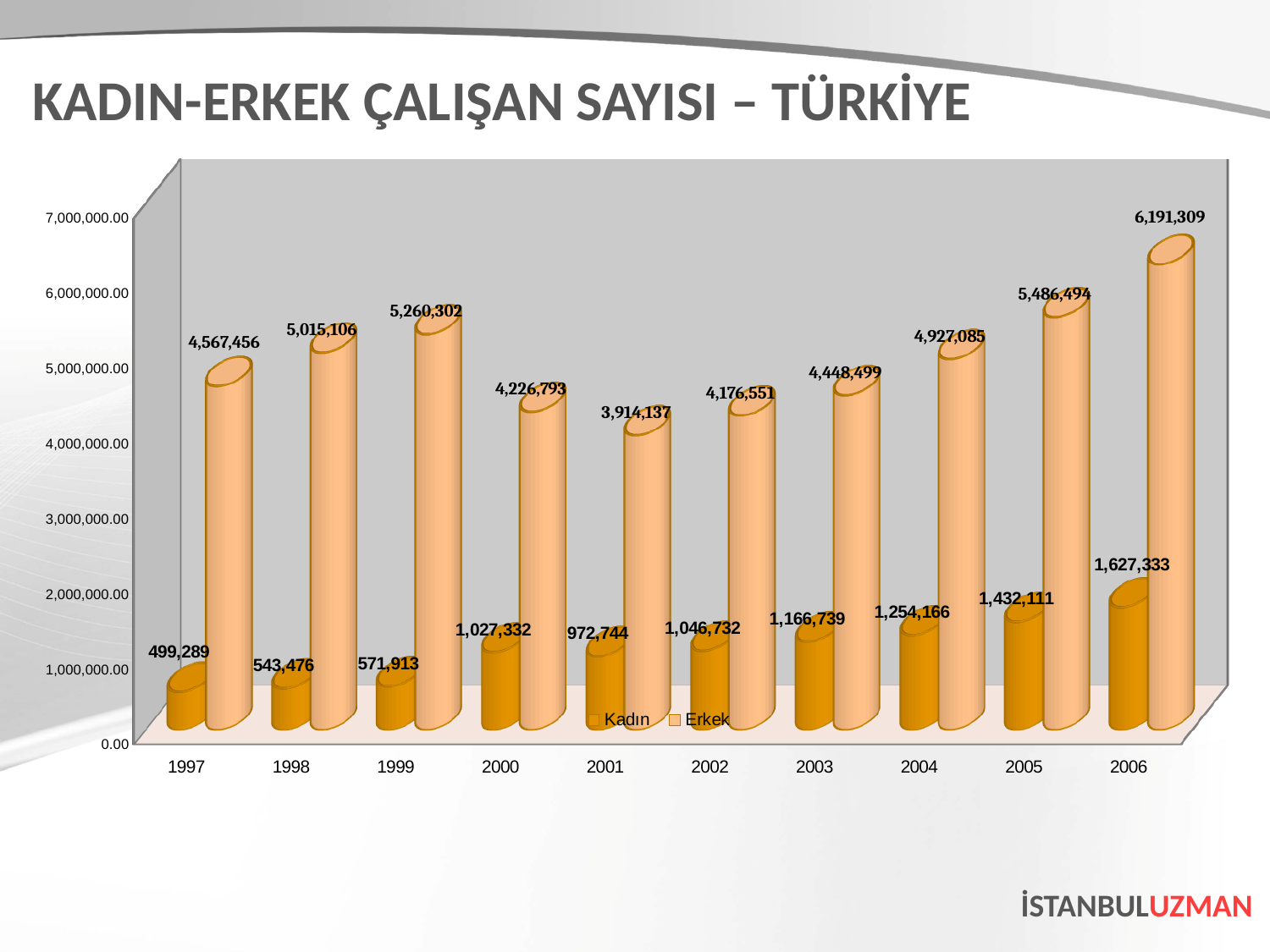
What is the difference between the Erkek and Kadın values in 2006? 4,563,976 How many years are shown on the x axis? 10 In which year is the Erkek value lowest? 2001 In which year is the Kadın value lowest? 1997 What is the Kadın value for 2003? 1,166,739 How many series does the legend list? 2 In which year is the Erkek value highest? 2006 What is the Kadın value for 1997? 499,289 What kind of chart is shown on the slide? Bar chart Which is larger, the Erkek value for 1999 or the Erkek value for 2000? 1999 What is the Erkek value for 2001? 3,914,137 What is the Erkek value for 2006? 6,191,309